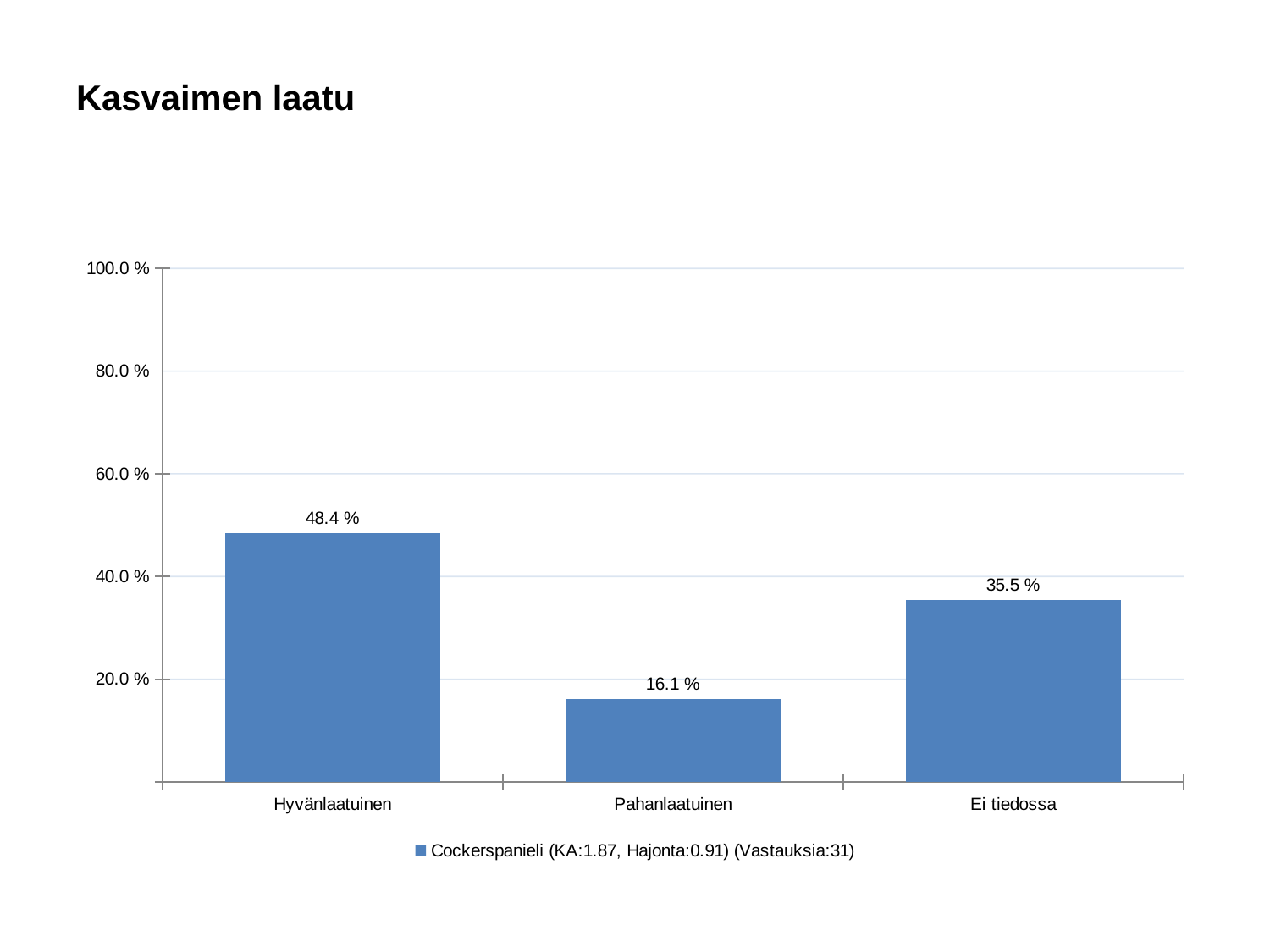
Which category has the highest value? Hyvänlaatuinen What is the value for Hyvänlaatuinen? 48.4 % Which is larger, the value for Ei tiedossa or the value for Pahanlaatuinen? Ei tiedossa What is the difference between the values for Hyvänlaatuinen and Ei tiedossa? 12.9 % How many categories are shown on the x axis? 3 What is the title of the slide? Kasvaimen laatu What is the value for Pahanlaatuinen? 16.1 % Which category has the lowest value? Pahanlaatuinen What is the difference between the values for Ei tiedossa and Pahanlaatuinen? 19.4 % Is the value for Hyvänlaatuinen greater or less than 40.0 %? greater What kind of chart is shown on the slide? bar chart What is the value for Ei tiedossa? 35.5 %